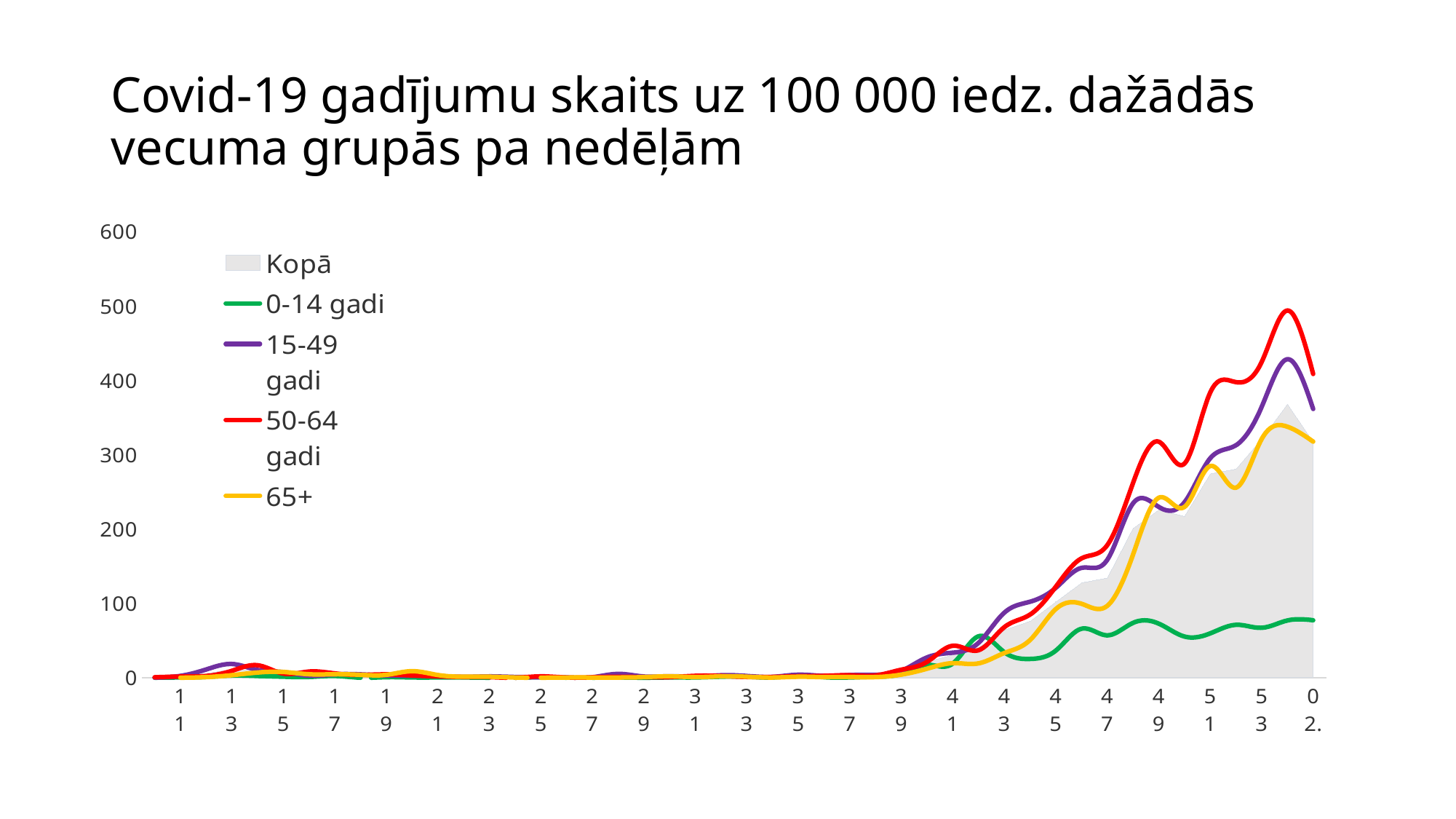
At the last point on the x axis (02), which is higher: 50-64 gadi or 65+? 50-64 gadi What colour is the line for the 65+ series? yellow How many labels are shown on the x axis? 23 Which age group series has the lowest values at the right end of the chart? 0-14 gadi Which age group series reaches the highest peak on the chart? 50-64 gadi Is the peak value of the 15-49 gadi series greater or less than 400? greater How many series does the legend list? 5 Is the peak value of the 50-64 gadi series greater or less than 400? greater What is the title of the chart? Covid-19 gadījumu skaits uz 100 000 iedz. dažādās vecuma grupās pa nedēļām Is the value of the 0-14 gadi series at week 53 greater or less than 100? less What kind of chart is shown on the slide? line and area chart Do the values of the 15-49 gadi series rise or fall between week 39 and week 53? rise